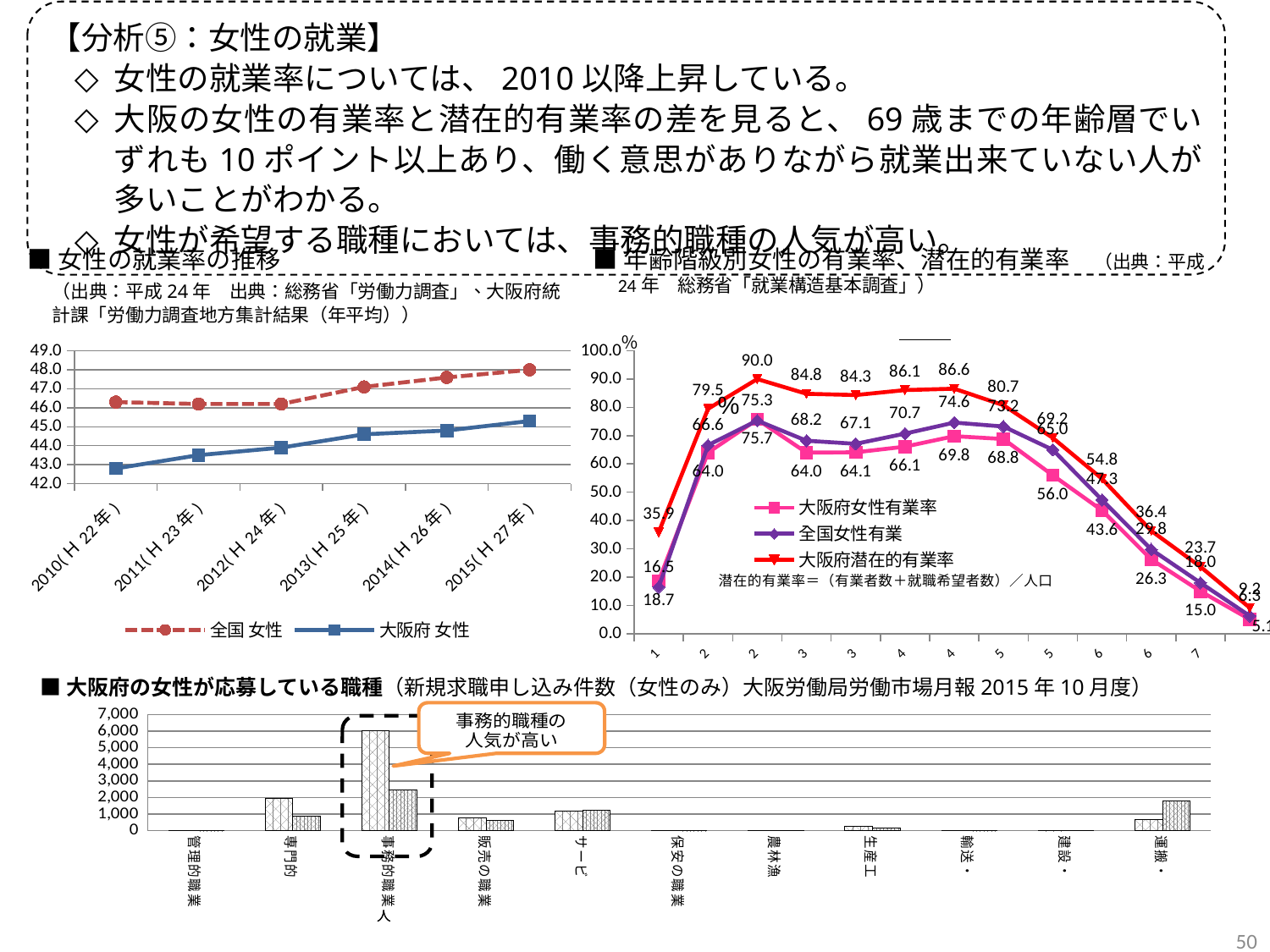
In the top-right chart (年齢階級別女性の有業率、潜在的有業率), how many series does the legend list? 3 In the top-right chart (年齢階級別女性の有業率、潜在的有業率), what is the difference between the peak of 大阪府潜在的有業率 (90.0) and the peak of 大阪府女性有業率 (75.7)? 14.3 In the top-left chart (女性の就業率の推移), is the value for 全国 女性 in 2015(H27年) greater or less than 47.0? greater In the top-left chart (女性の就業率の推移), how many series does the legend list? 2 In the top-left chart (女性の就業率の推移), does the 大阪府 女性 line rise or fall from 2010 to 2015? rises In the top-left chart (女性の就業率の推移), how many years are shown on the x axis? 6 What type of chart is the top-left chart titled 女性の就業率の推移? line chart What type of chart is the bottom chart titled 大阪府の女性が応募している職種? bar chart In the top-right chart (年齢階級別女性の有業率、潜在的有業率), what is the first (leftmost) value of the 大阪府潜在的有業率 series? 35.9 In the top-right chart (年齢階級別女性の有業率、潜在的有業率), at the last (rightmost) age group, which is larger: 大阪府潜在的有業率 or 大阪府女性有業率? 大阪府潜在的有業率 In the top-right chart (年齢階級別女性の有業率、潜在的有業率), what is the highest value of the 大阪府潜在的有業率 series? 90.0 In the bottom chart (大阪府の女性が応募している職種), which occupation category has the tallest bar? 事務的職業